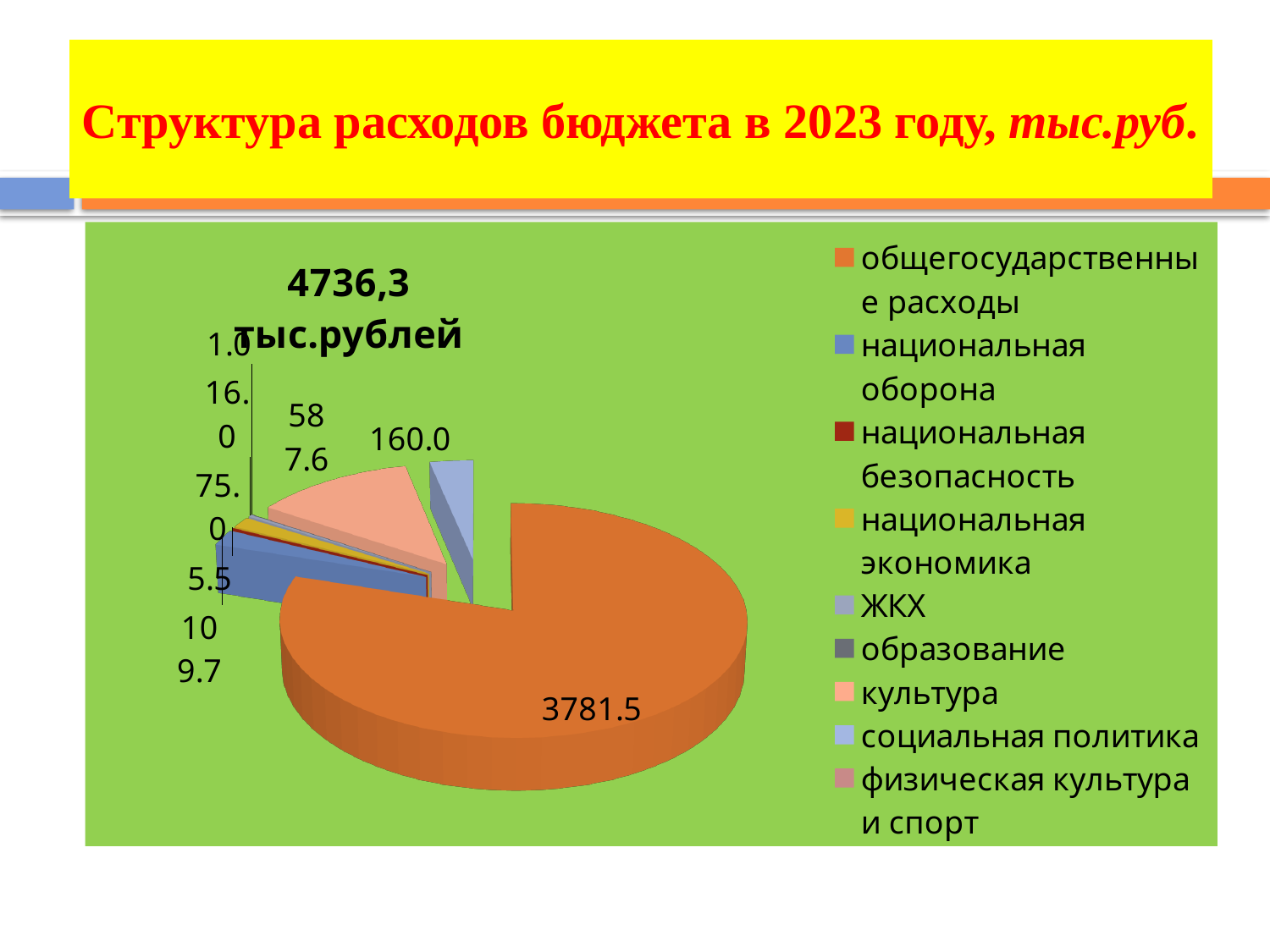
What is the value shown for культура? 587.6 Which category has the largest slice in the pie chart? общегосударственные расходы How many categories does the legend of the pie chart list? 9 What is the value shown for общегосударственные расходы? 3781.5 Which category is listed last in the legend? физическая культура и спорт What total is given in the chart title? 4736,3 тыс.рублей Which is larger, общегосударственные расходы or культура? общегосударственные расходы What kind of chart is shown on the slide? pie chart What colour is the slice for общегосударственные расходы? orange